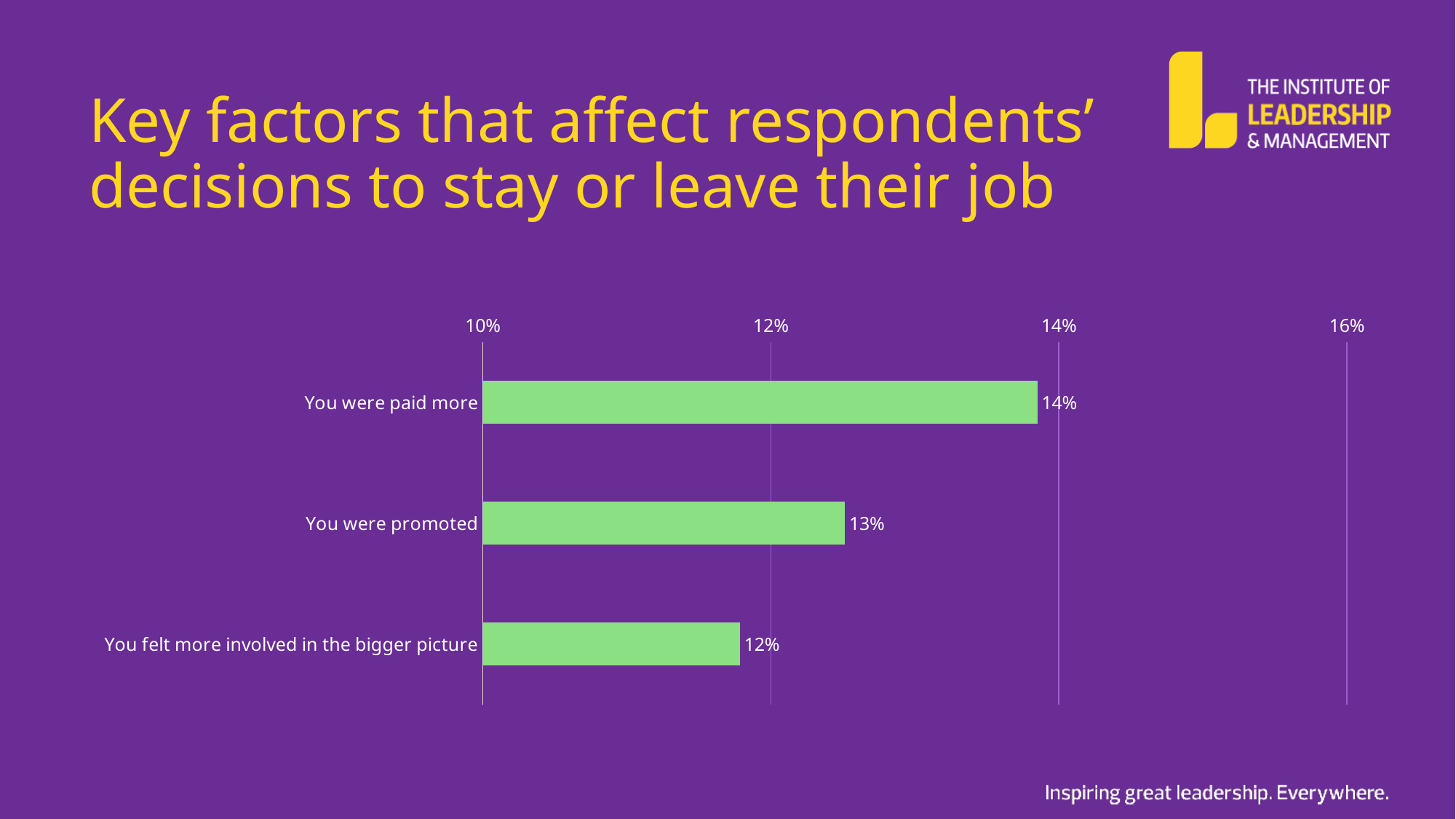
Which factor has the lowest value? You felt more involved in the bigger picture What is the difference between the values for "You were promoted" and "You felt more involved in the bigger picture"? 1% What is the title of the slide? Key factors that affect respondents' decisions to stay or leave their job How many factors are shown in the chart? 3 Is the value for "You were promoted" greater or less than 12%? greater What kind of chart is shown on the slide? Bar chart Which factor has the highest value? You were paid more What is the value for "You felt more involved in the bigger picture"? 12% What is the value for "You were promoted"? 13% What is the value for "You were paid more"? 14% Which is larger, the value for "You were promoted" or the value for "You felt more involved in the bigger picture"? You were promoted What is the difference between the values for "You were paid more" and "You felt more involved in the bigger picture"? 2%